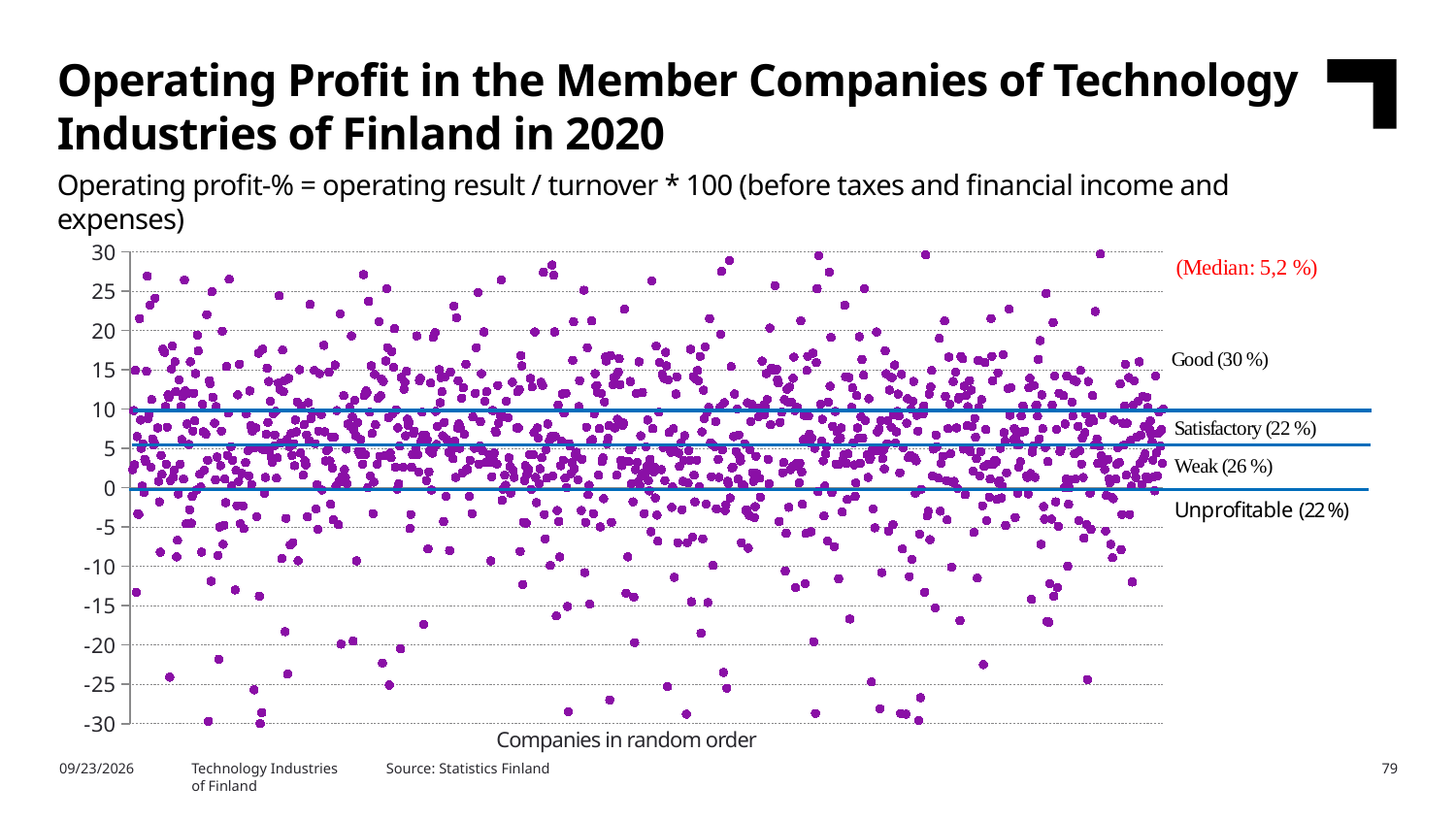
What share of companies falls into the 'Weak' category? 26 % How many profitability categories are labelled on the chart? 4 What share of companies falls into the 'Unprofitable' category? 22 % What share of companies falls into the 'Good' category? 30 % What is the label of the x axis? Companies in random order What kind of chart is shown on the slide? Scatter chart Which profitability category has the largest share of companies? Good What is the difference in percentage points between the 'Good' share and the 'Weak' share? 4 percentage points Is the median operating profit-% greater or less than 5? greater What is the median operating profit-% shown on the chart? 5,2 % Which has a larger share of companies, 'Good' or 'Weak'? Good What is the highest value shown on the y axis? 30